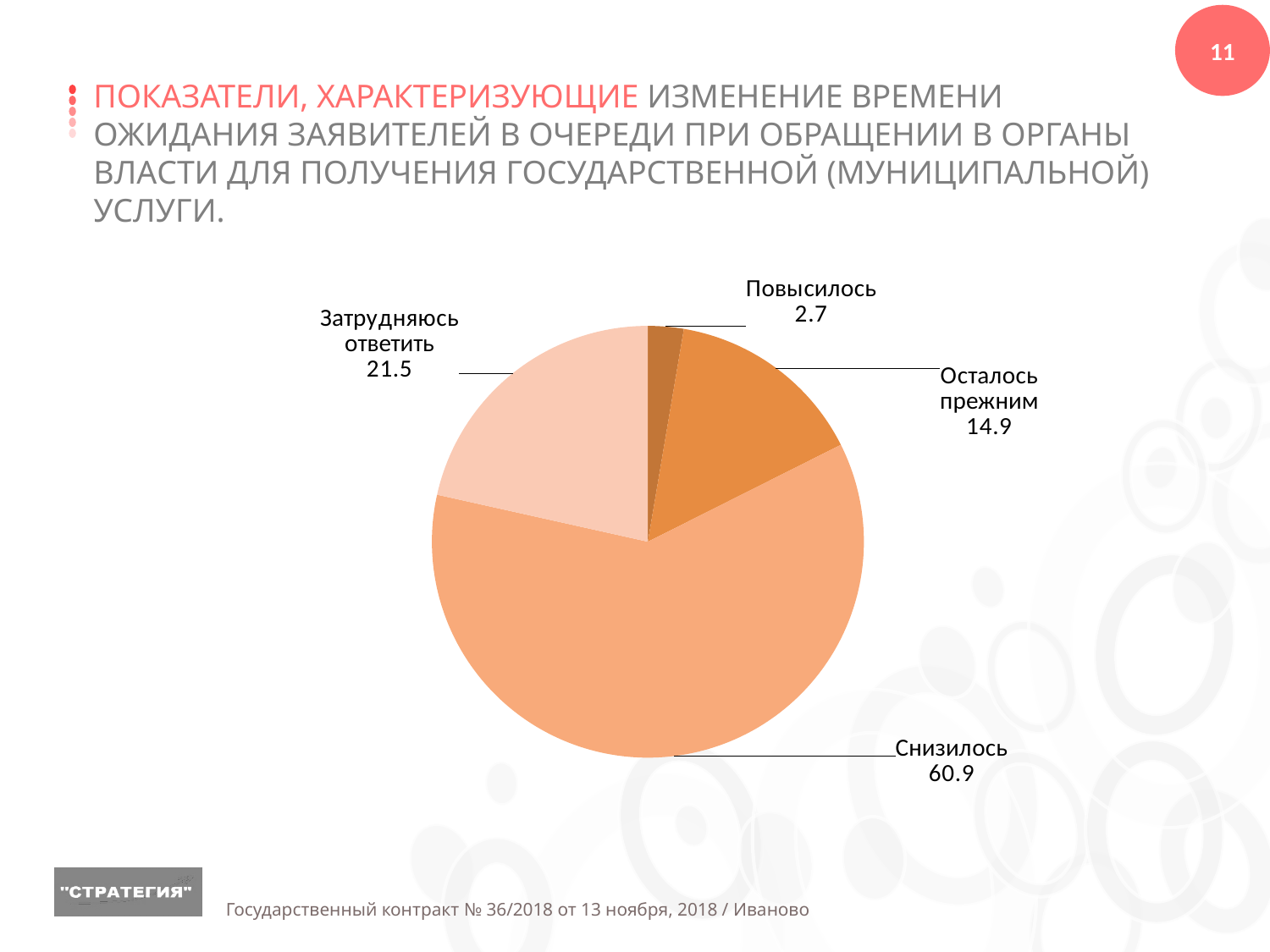
What is the difference between the values for Снизилось and Затрудняюсь ответить? 39.4 What is the difference between the values for Осталось прежним and Повысилось? 12.2 What is the value for Затрудняюсь ответить? 21.5 What is the value for Повысилось? 2.7 What kind of chart is shown on the slide? pie chart Which is larger, the value for Затрудняюсь ответить or the value for Осталось прежним? Затрудняюсь ответить Which category has the largest slice? Снизилось What is the value for Снизилось? 60.9 Which category has the smallest slice? Повысилось Which slice of the pie is the darkest in colour? Повысилось What is the value for Осталось прежним? 14.9 How many slices does the pie chart have? 4